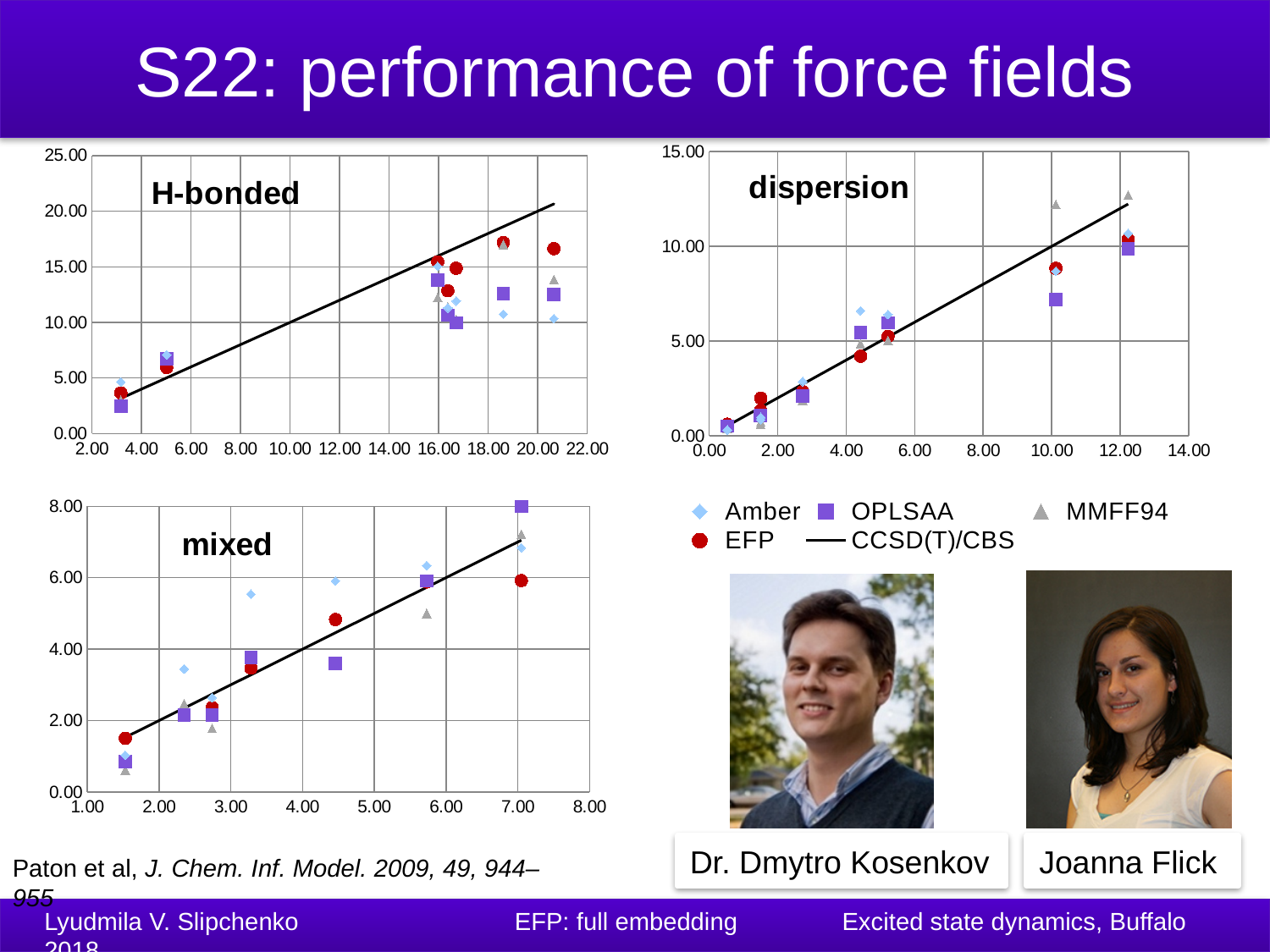
What kind of chart is the 'H-bonded' chart? scatter chart Which series in the legend is drawn as a line rather than markers? CCSD(T)/CBS In the 'H-bonded' chart, is the EFP point at the far right (x ≈ 20.6) greater or less than 15.00? greater In the 'mixed' chart, near x = 4.50, which is higher: the EFP point or the OPLSAA point? EFP How many charts are shown on the slide? 3 In the 'dispersion' chart, is the MMFF94 point near x = 12.00 greater or less than 10.00? greater In the 'dispersion' chart, is the OPLSAA point near x = 10.00 greater or less than 10.00? less What is the maximum value shown on the y axis of the 'dispersion' chart? 15.00 In the 'dispersion' chart, near x = 10.00, which is higher: the EFP point or the OPLSAA point? EFP In the 'dispersion' chart, does the CCSD(T)/CBS line rise or fall as x increases? rises How many series does the shared legend list? 5 In the 'mixed' chart, does the CCSD(T)/CBS line rise or fall as x increases? rises